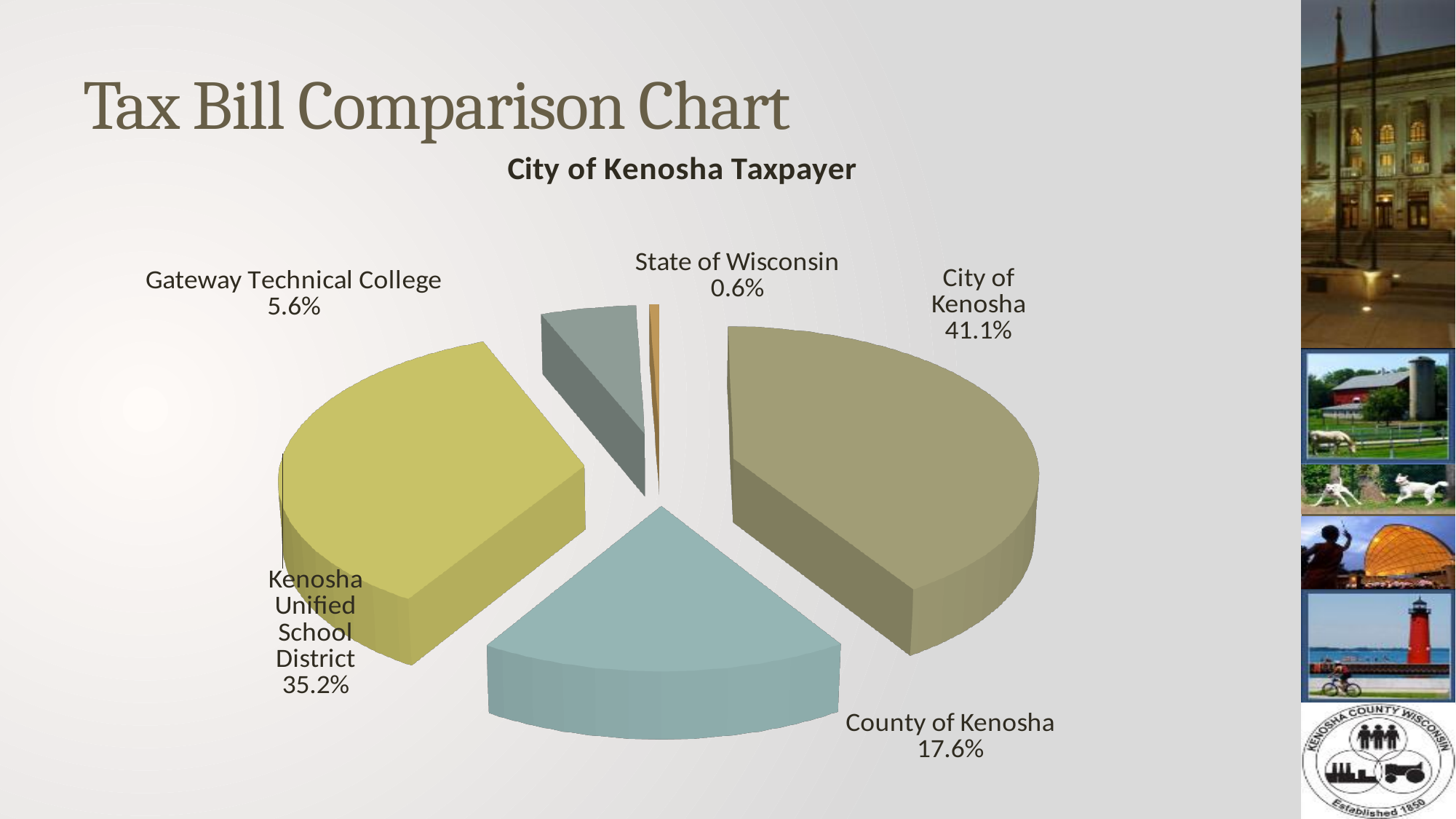
What percentage is shown for the Kenosha Unified School District? 35.2% What type of chart is shown on the slide? Pie chart How many slices does the pie chart have? 5 Which category has the smallest slice of the pie? State of Wisconsin What percentage is shown for the County of Kenosha? 17.6% What is the difference in percentage points between the City of Kenosha and the Kenosha Unified School District? 5.9 What percentage is shown for Gateway Technical College? 5.6% Which category has the largest slice of the pie? City of Kenosha Which is larger, the County of Kenosha share or the Gateway Technical College share? County of Kenosha What share of the City of Kenosha Taxpayer pie goes to the City of Kenosha? 41.1% What percentage is shown for the State of Wisconsin? 0.6% What is the title of the chart? City of Kenosha Taxpayer